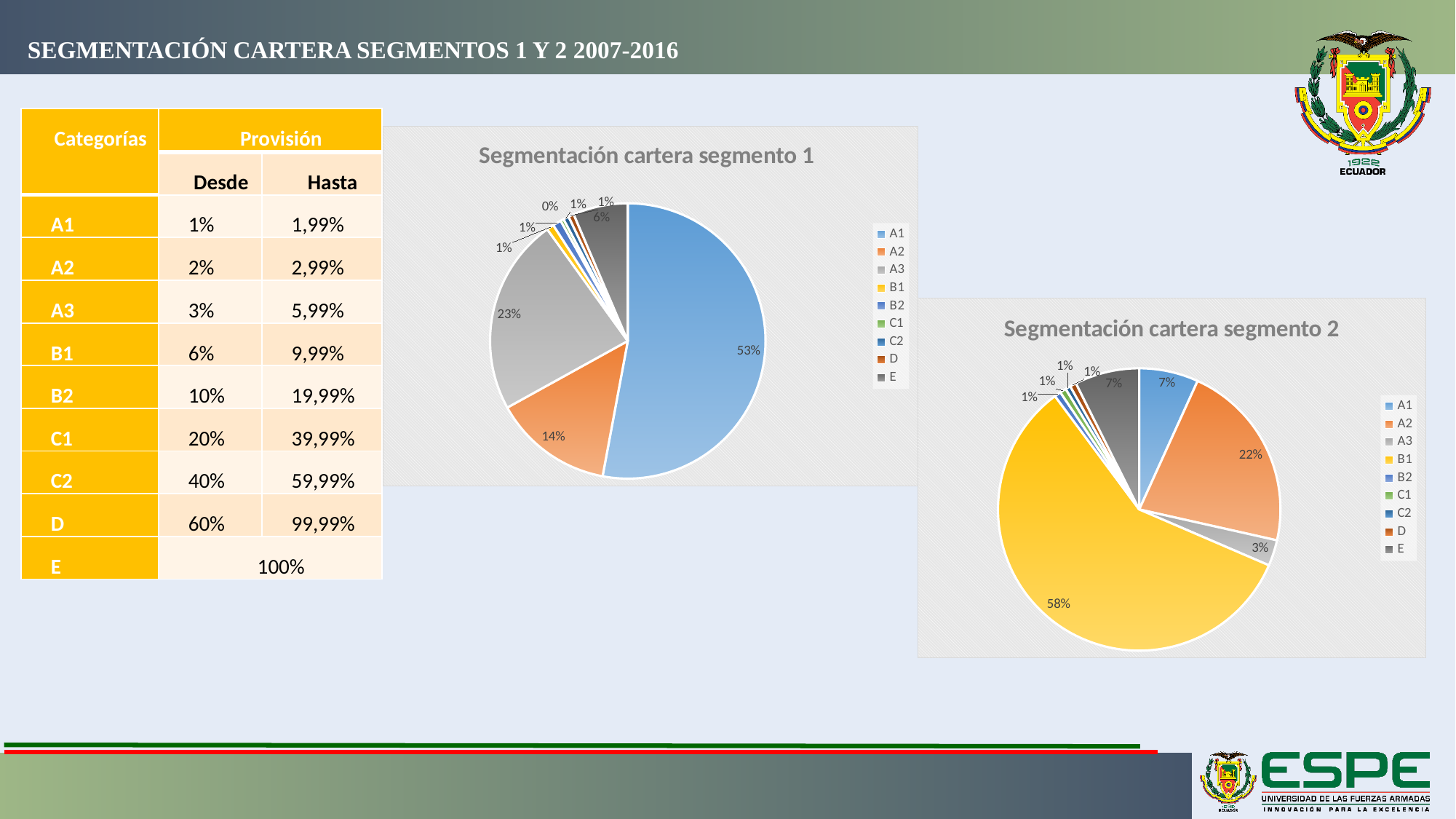
In the 'Segmentación cartera segmento 2' chart, what share does B1 have? 58% In the 'Segmentación cartera segmento 1' chart, what share does E have? 6% What type of chart is 'Segmentación cartera segmento 2'? Pie chart In the 'Segmentación cartera segmento 1' chart, which category has the largest slice? A1 In the 'Segmentación cartera segmento 1' chart, what share does A1 have? 53% In the 'Segmentación cartera segmento 2' chart, what share does A3 have? 3% How many categories does the legend of the 'Segmentación cartera segmento 1' chart list? 9 In the 'Segmentación cartera segmento 1' chart, what share does A2 have? 14% In the 'Segmentación cartera segmento 2' chart, what share does A2 have? 22% In the 'Segmentación cartera segmento 2' chart, which category has the largest slice? B1 In the 'Segmentación cartera segmento 1' chart, what share does A3 have? 23% In the 'Segmentación cartera segmento 2' chart, what is the difference in percentage points between B1 and A2? 36